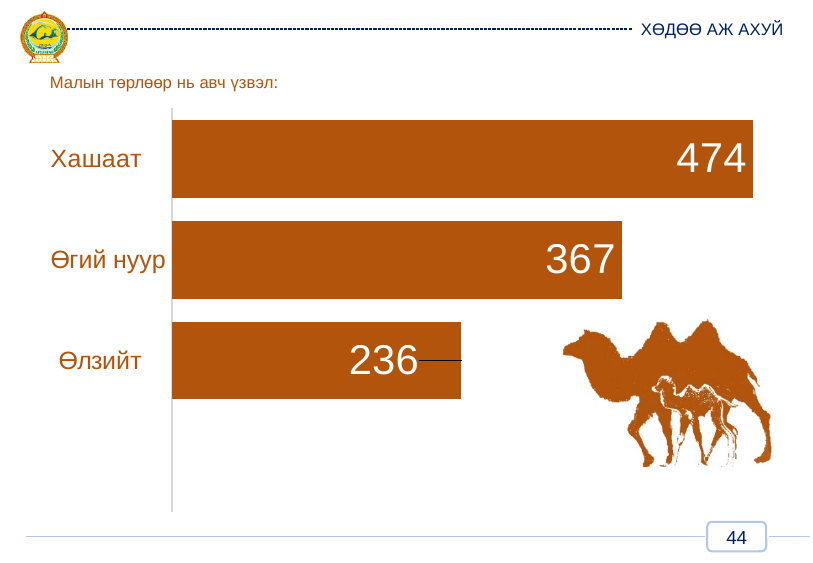
What is the difference between the values for Өгий нуур and Өлзийт? 131 What is the value for Хашаат? 474 What kind of chart is shown on the slide? bar chart What is the value for Өгий нуур? 367 What is the total of the three values shown in the chart? 1077 What is the difference between the values for Хашаат and Өгий нуур? 107 Which category has the lowest value? Өлзийт What colour are the bars in the chart? brown What is the value for Өлзийт? 236 How many categories are shown in the chart? 3 Which category has the highest value? Хашаат Which is larger, the value for Өгий нуур or the value for Өлзийт? Өгий нуур